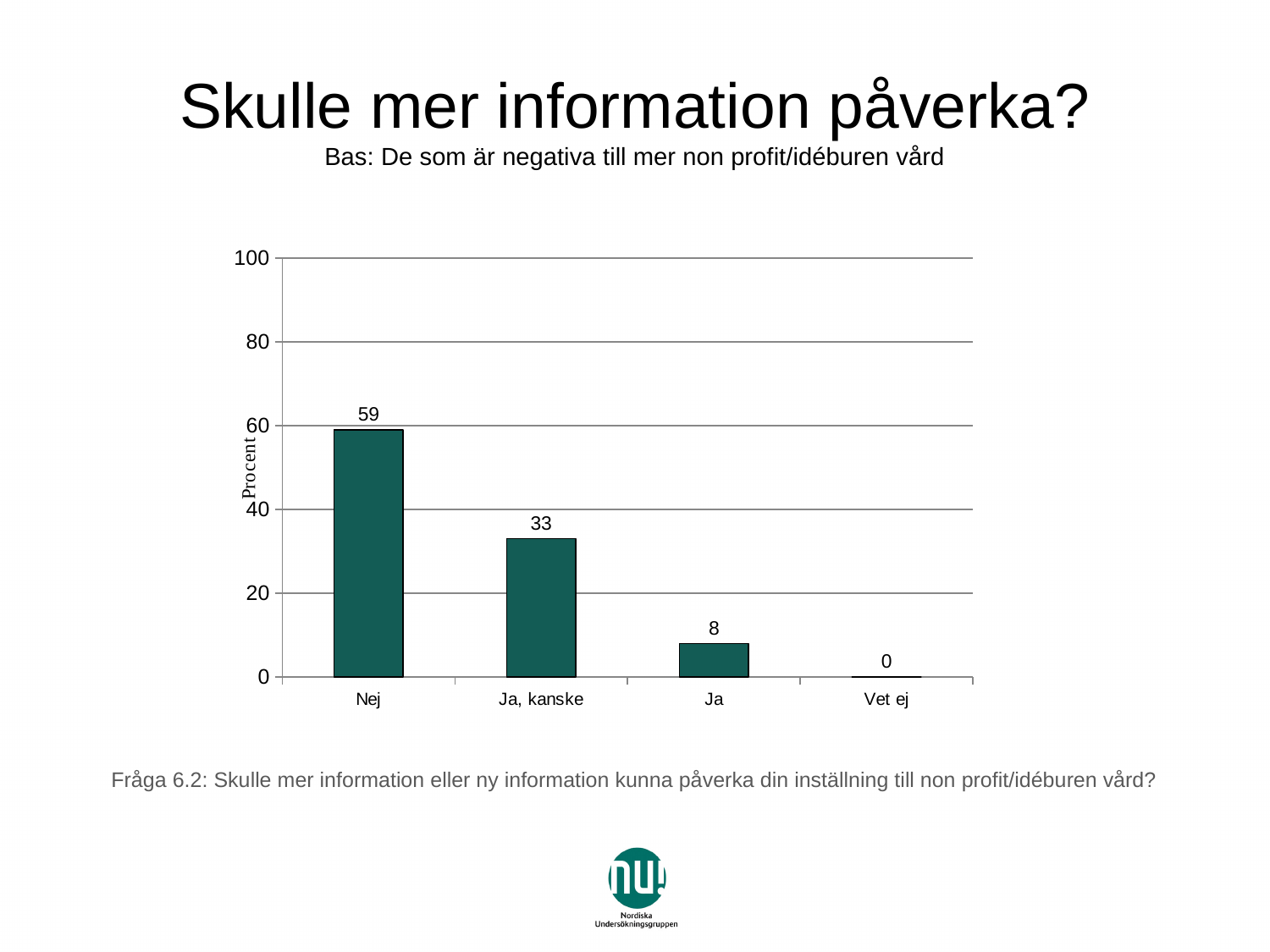
How many categories are shown on the x axis? 4 What kind of chart is shown on the slide? bar chart What is the value for Nej? 59 Which category has the lowest value? Vet ej Is the value for Nej greater or less than 40? greater Which is larger, the value for Ja, kanske or the value for Ja? Ja, kanske What is the value for Ja? 8 What is the difference between the values for Nej and Ja, kanske? 26 What is the value for Vet ej? 0 Which category has the highest value? Nej What is the label of the y axis? Procent What is the value for Ja, kanske? 33